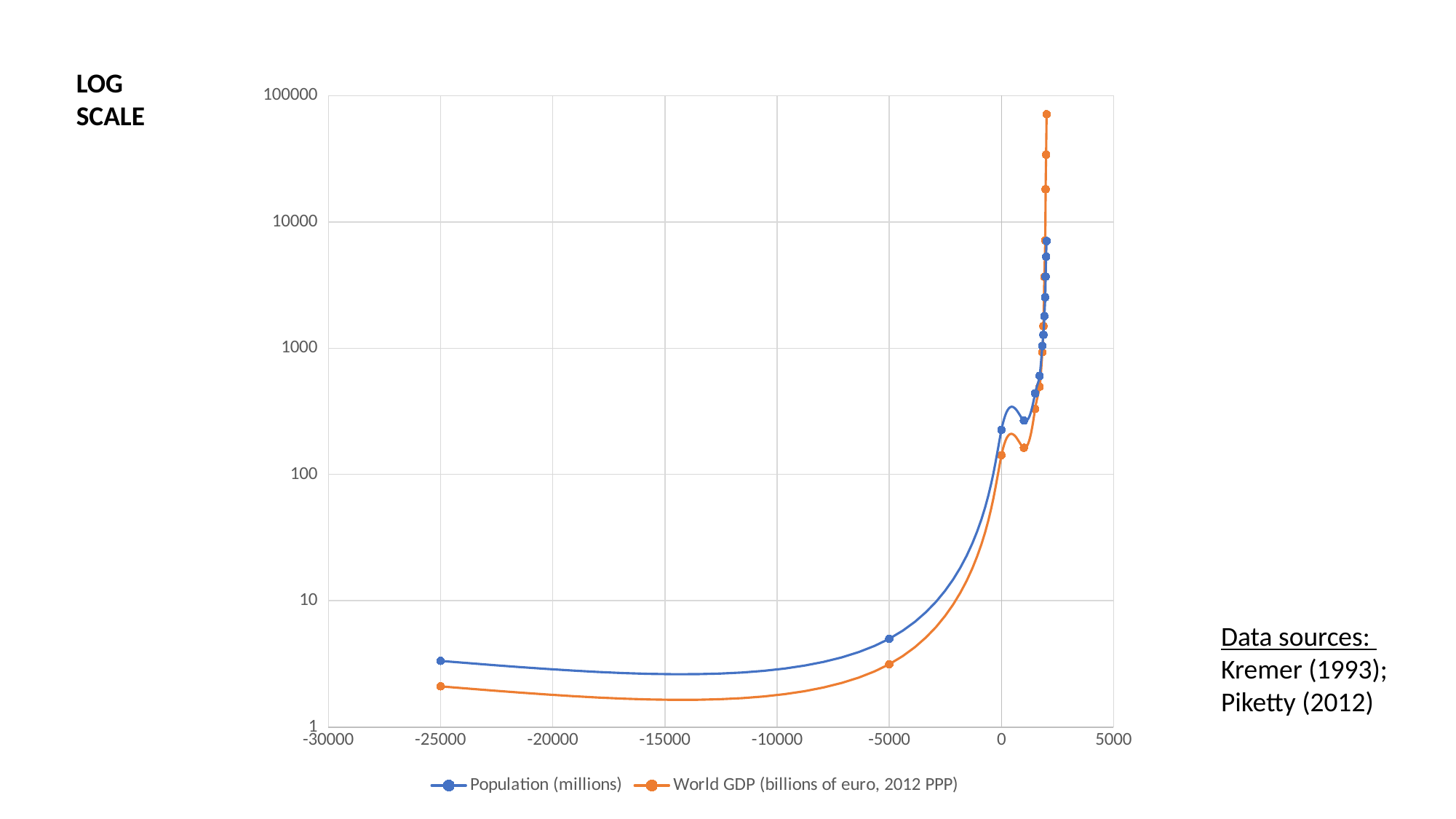
What are the two series named in the legend? Population (millions) and World GDP (billions of euro, 2012 PPP) At -25000, which series has the higher value, Population (millions) or World GDP (billions of euro, 2012 PPP)? Population (millions) Overall, do the values of the World GDP (billions of euro, 2012 PPP) series rise or fall from left to right along the x axis? rise At the most recent point on the right, which series has the higher value, Population (millions) or World GDP (billions of euro, 2012 PPP)? World GDP (billions of euro, 2012 PPP) What kind of chart is shown on the slide? line chart What kind of scale does the vertical axis use, according to the label at the top left of the slide? log scale Is the most recent value for World GDP (billions of euro, 2012 PPP) greater or less than 10000? greater Is the most recent value for Population (millions) greater or less than 10000? less Is the value for Population (millions) at 0 greater or less than 100? greater How many series does the legend list? 2